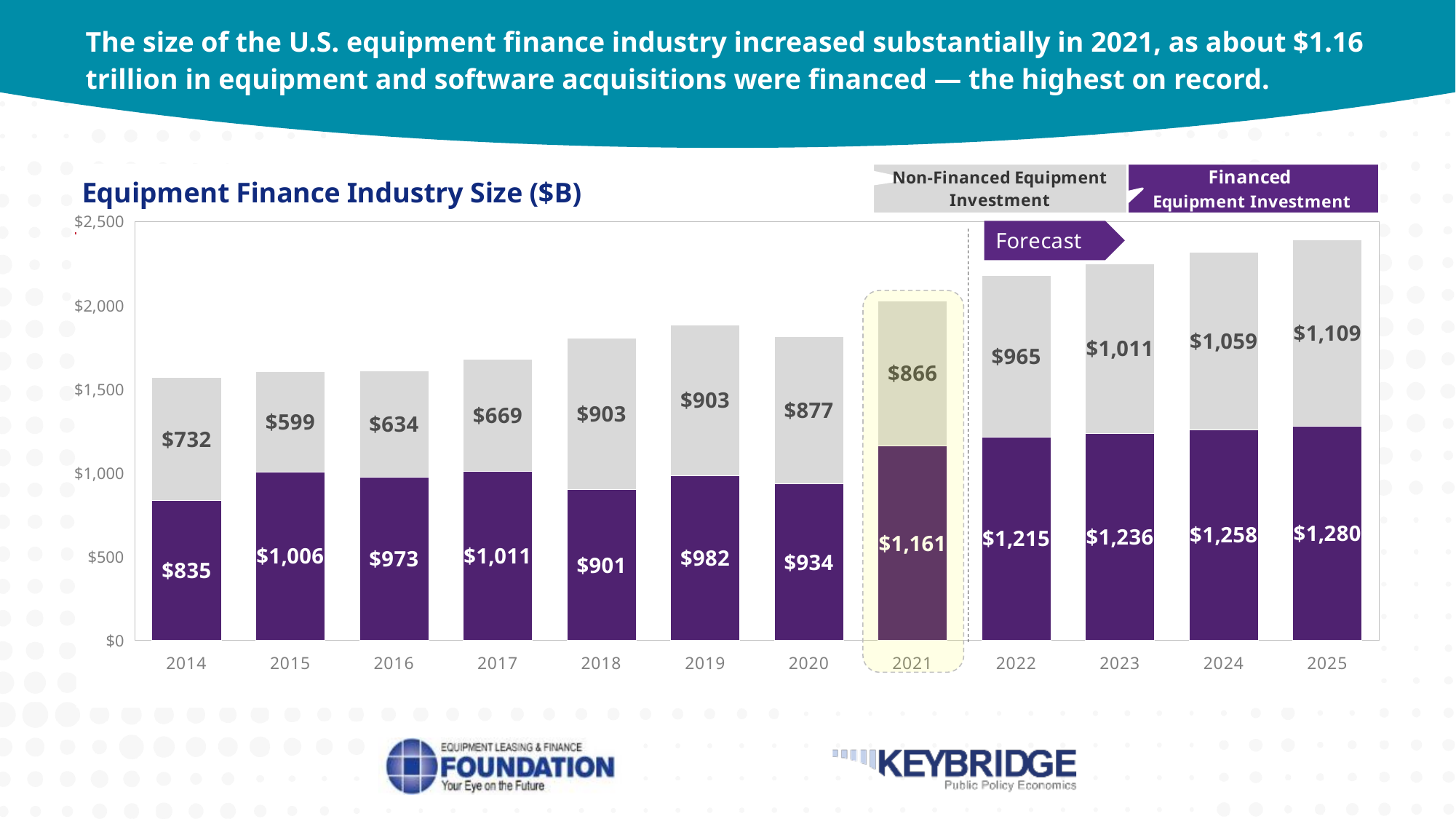
What is the Non-Financed Equipment Investment value for 2018? $903 How many years are shown on the x axis? 12 What is the total of the 2025 stacked bar? $2,389 Which is larger in 2020: Financed Equipment Investment or Non-Financed Equipment Investment? Financed Equipment Investment Which year has the lowest Non-Financed Equipment Investment value? 2015 How many series does the legend list? 2 What is the difference between the Financed Equipment Investment values for 2025 and 2014? $445 What is the Financed Equipment Investment value for 2021? $1,161 Which year has the highest Financed Equipment Investment value? 2025 What kind of chart is shown on the slide? Stacked bar chart Is the total height of the 2021 stacked bar greater or less than $2,000? greater What is the title of the chart? Equipment Finance Industry Size ($B)